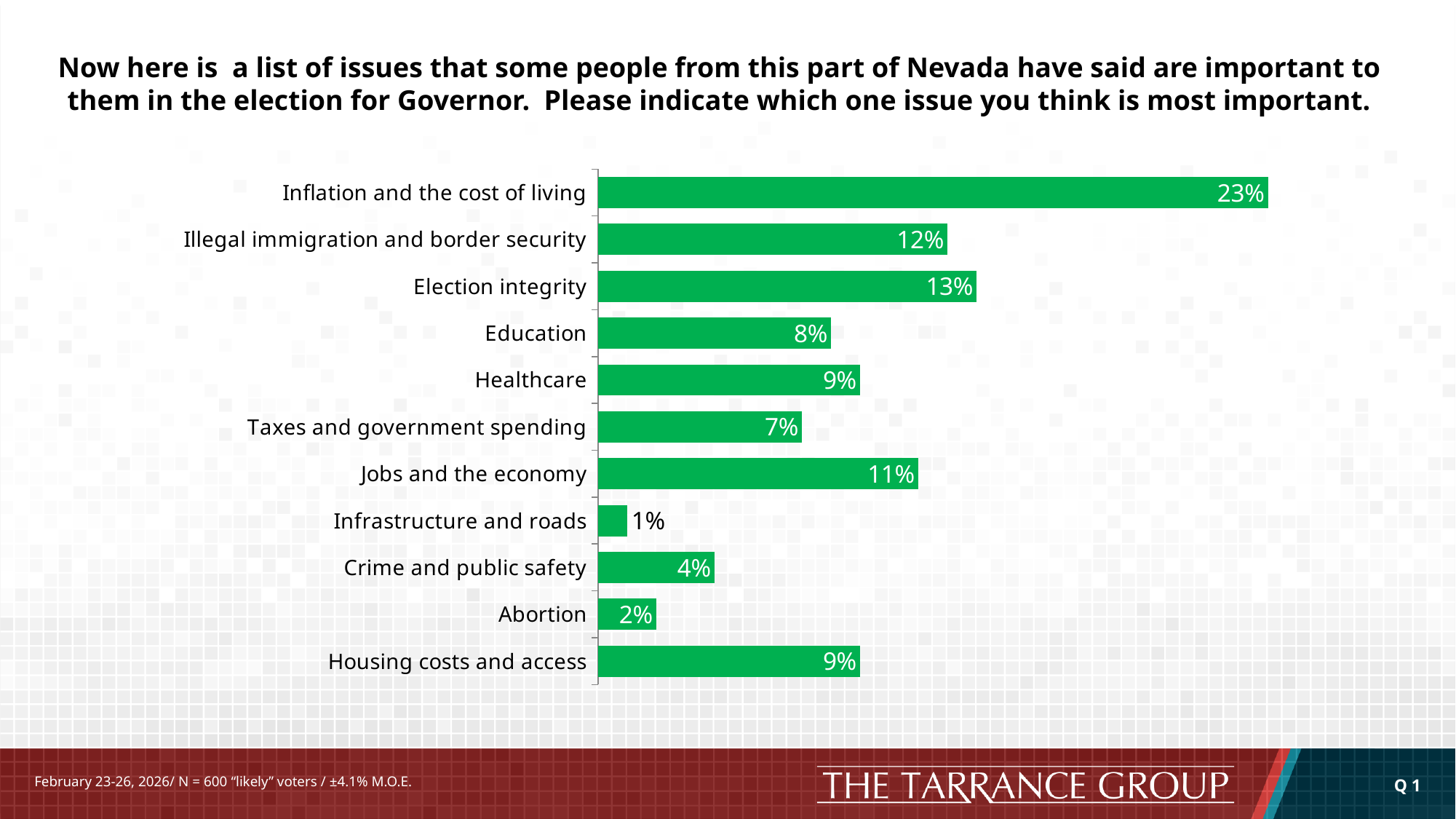
How many issues are listed in the chart? 11 Which is larger, the value for Education or the value for Housing costs and access? Housing costs and access What is the difference between the values for Healthcare and Taxes and government spending? 2% Which is larger, the value for Election integrity or the value for Illegal immigration and border security? Election integrity Which issue has the lowest percentage? Infrastructure and roads What is the value for Crime and public safety? 4% What is the difference between the values for Inflation and the cost of living and Illegal immigration and border security? 11% What is the value shown for Election integrity? 13% What percentage of respondents chose Inflation and the cost of living as the most important issue? 23% What percentage is shown for Jobs and the economy? 11% Which issue has the highest percentage? Inflation and the cost of living What kind of chart is shown on the slide? Bar chart